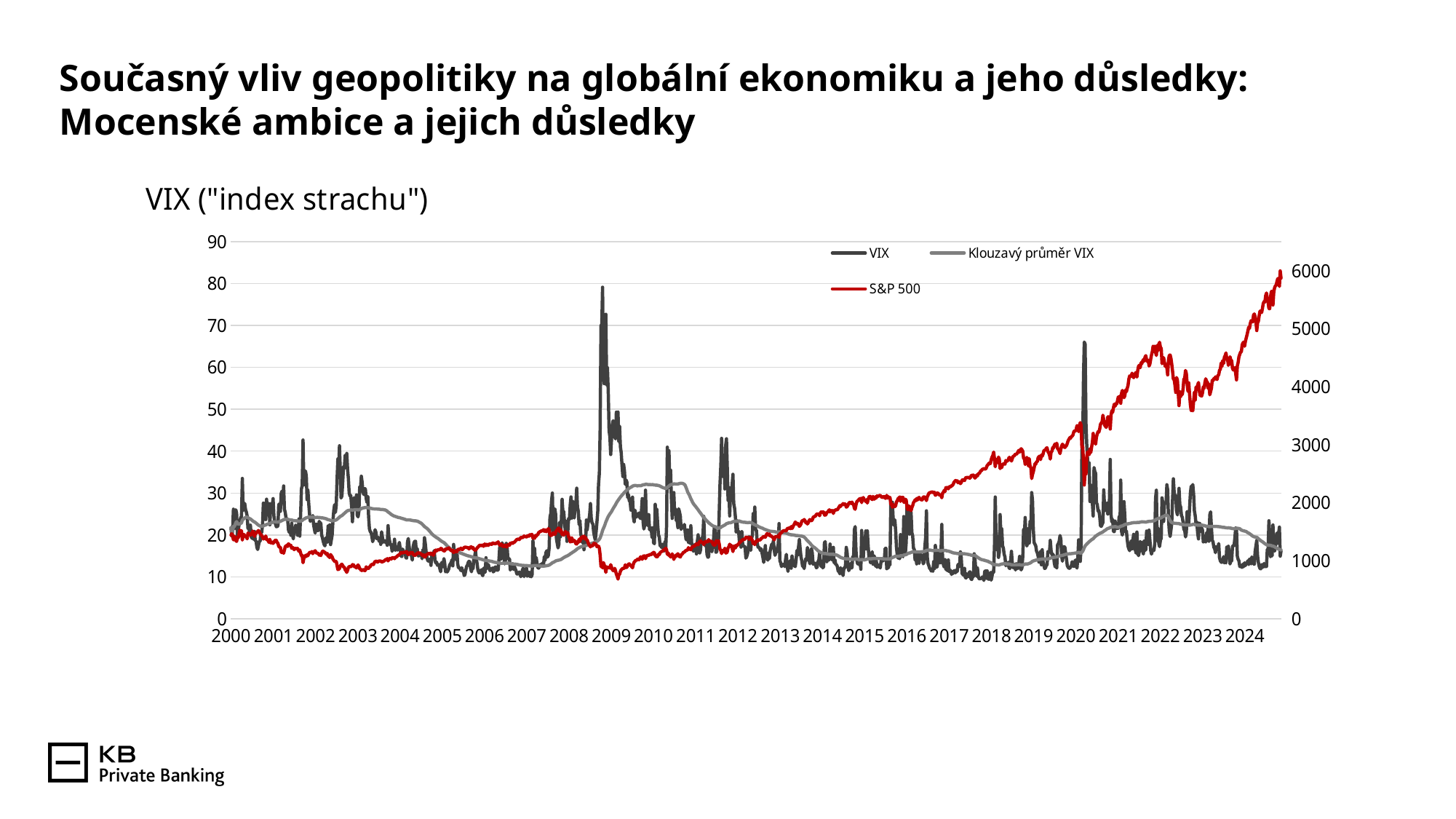
Is the VIX peak around 2020 greater or less than 60? greater Does the S&P 500 series generally rise or fall from 2009 to 2024? rise Is the S&P 500 value at the start of 2021 greater or less than 3000? greater What is the title of the chart? VIX ("index strachu") Which is higher, the VIX peak around 2008 or the VIX peak around 2020? the VIX peak around 2008 Is the S&P 500 value at the end of 2024 greater or less than 5000? greater What kind of chart is shown on the slide? line chart How many year labels are shown on the x axis? 25 How many series does the chart legend list? 3 What are the series listed in the chart legend? VIX, Klouzavý průměr VIX, S&P 500